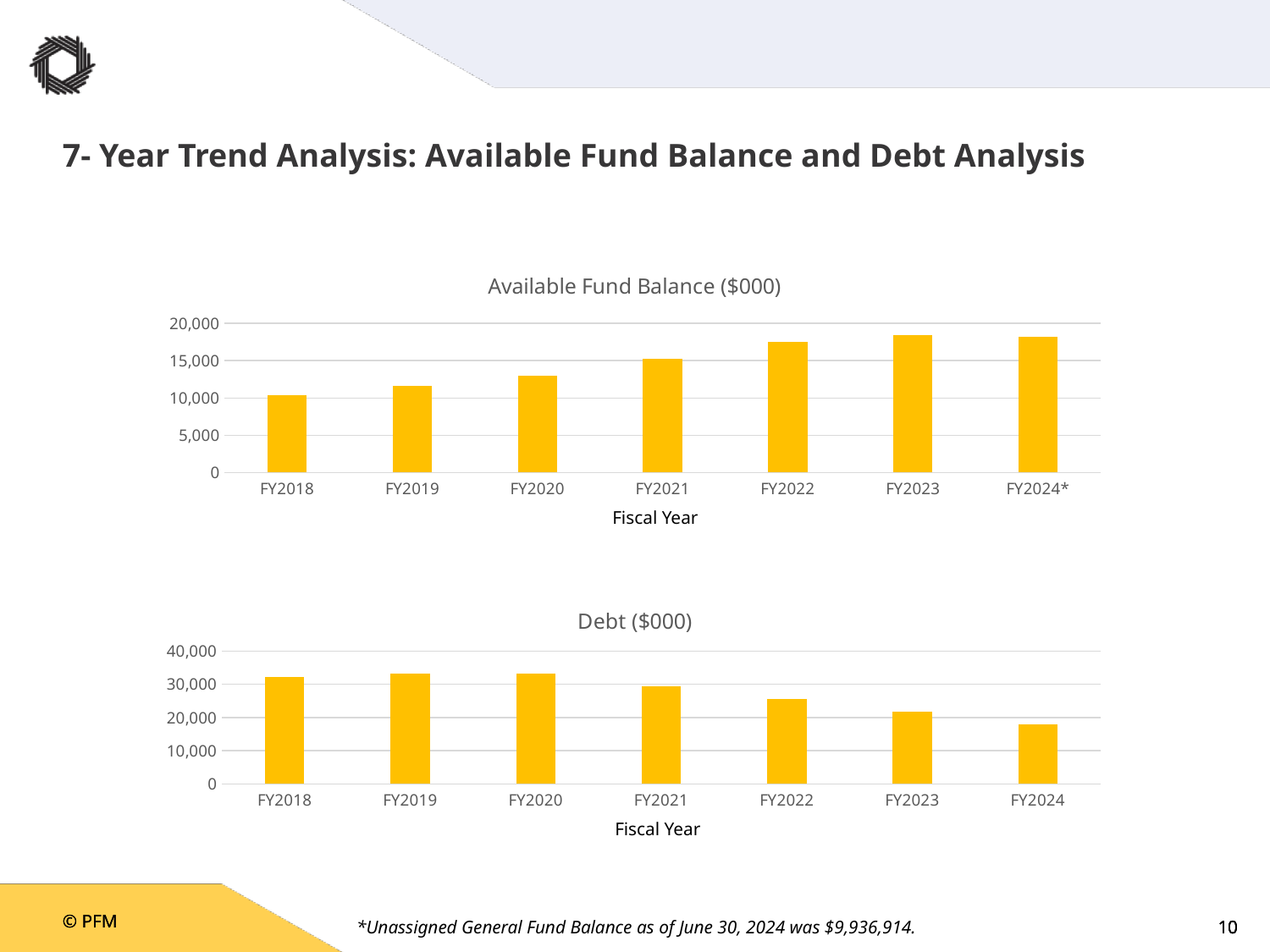
On the 'Debt ($000)' chart, which fiscal year has the lowest value? FY2024 On the 'Available Fund Balance ($000)' chart, do the values generally rise or fall from FY2018 to FY2023? rise What is the x-axis title on the 'Available Fund Balance ($000)' chart? Fiscal Year On the 'Available Fund Balance ($000)' chart, which fiscal year has the lowest value? FY2018 On the 'Debt ($000)' chart, do the values rise or fall from FY2020 to FY2024? fall What type of chart is the 'Available Fund Balance ($000)' chart? bar chart On the 'Available Fund Balance ($000)' chart, is the value for FY2020 greater or less than 15,000? less On the 'Debt ($000)' chart, is the value for FY2024 greater or less than 20,000? less How many fiscal years are shown on the 'Debt ($000)' chart? 7 On the 'Debt ($000)' chart, which is larger, the value for FY2019 or the value for FY2023? FY2019 On the 'Debt ($000)' chart, is the value for FY2018 greater or less than 30,000? greater